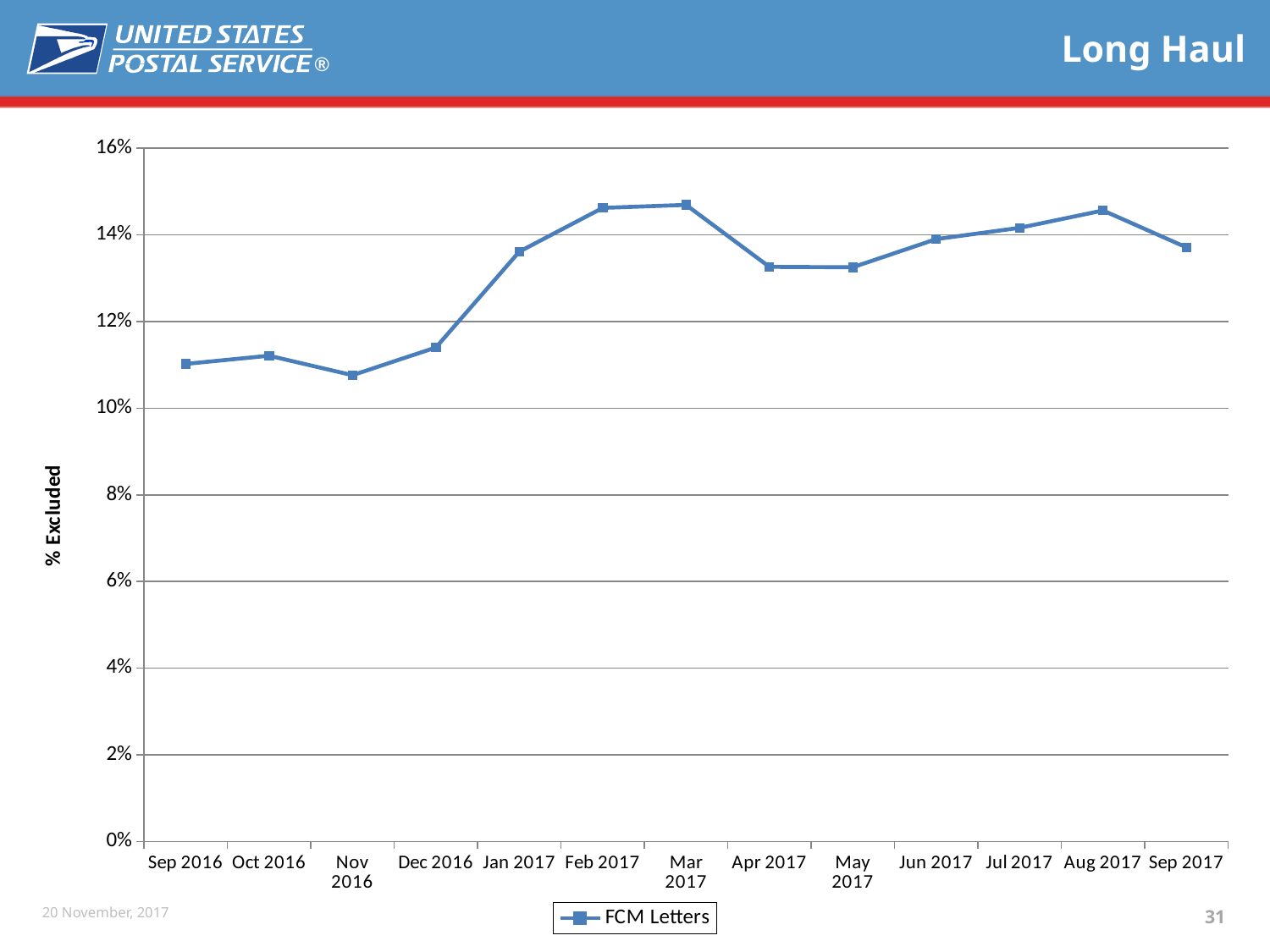
What is the title of the vertical axis? % Excluded Is the value for Sep 2016 greater or less than 10%? greater What is the name of the series shown in the legend? FCM Letters Is the value for Nov 2016 greater or less than 12%? less How many series does the legend list? 1 Is the value for Apr 2017 greater or less than 14%? less Which is larger, the value for Dec 2016 or the value for Jan 2017? Jan 2017 Which month has the lowest value for FCM Letters? Nov 2016 Does the value rise or fall from Aug 2017 to Sep 2017? fall What kind of chart is shown on the slide? line chart How many months are plotted along the x axis? 13